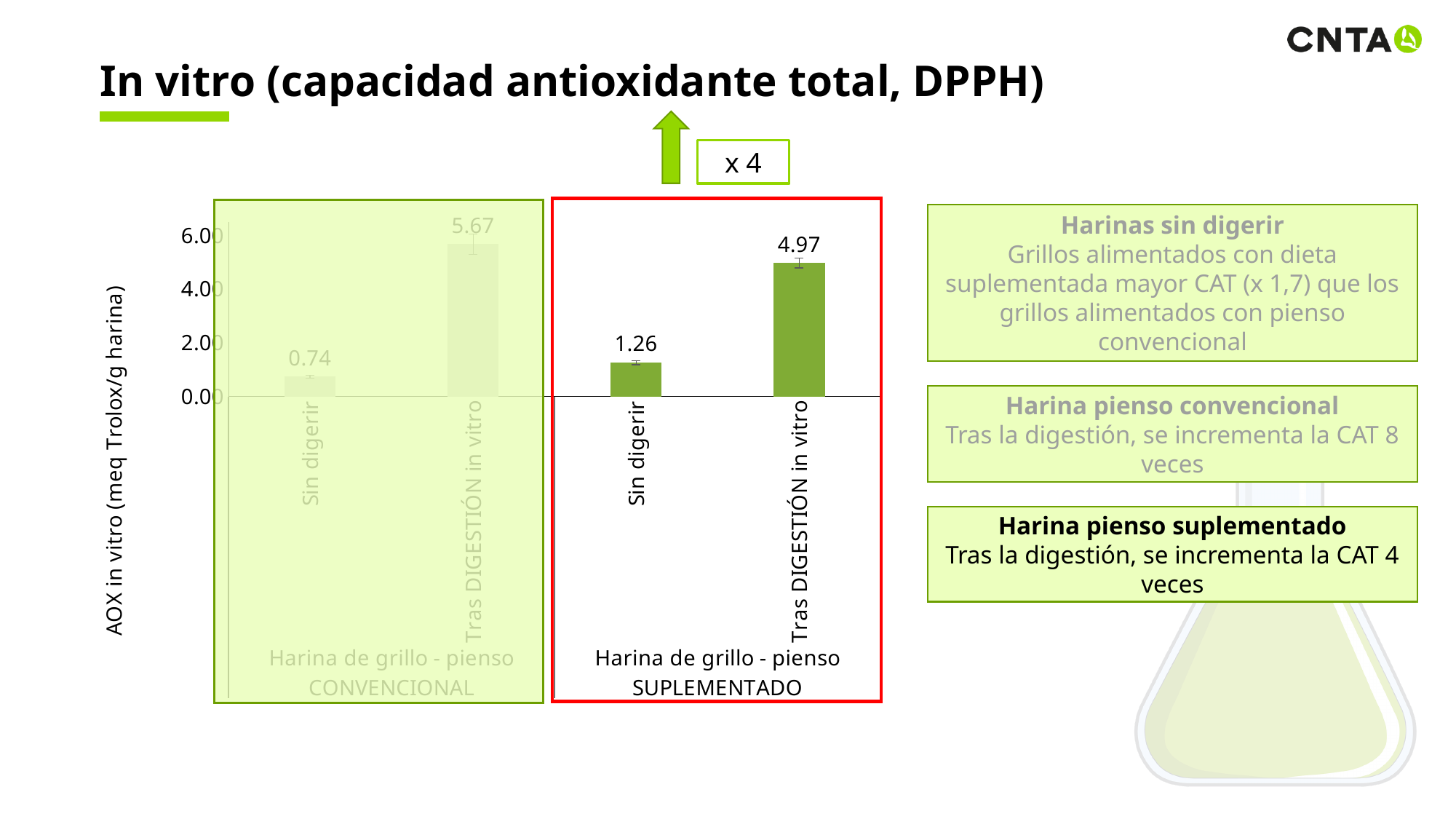
What is the value for 'Tras DIGESTIÓN in vitro' in the 'Harina de grillo - pienso SUPLEMENTADO' group? 4.97 Which bar has the lowest value in the chart? Sin digerir (CONVENCIONAL) Is the 'Tras DIGESTIÓN in vitro' value for SUPLEMENTADO greater or less than 4.00? greater How many bars are plotted in the chart? 4 What is the difference between the 'Tras DIGESTIÓN in vitro' values of the CONVENCIONAL and SUPLEMENTADO groups? 0.70 What is the label of the vertical axis of the chart? AOX in vitro (meq Trolox/g harina) What is the value for 'Sin digerir' in the 'Harina de grillo - pienso SUPLEMENTADO' group? 1.26 Which bar has the highest value in the chart? Tras DIGESTIÓN in vitro (CONVENCIONAL) Which is larger: the 'Sin digerir' value for CONVENCIONAL or for SUPLEMENTADO? SUPLEMENTADO What is the value for 'Tras DIGESTIÓN in vitro' in the 'Harina de grillo - pienso CONVENCIONAL' group? 5.67 What is the value for 'Sin digerir' in the 'Harina de grillo - pienso CONVENCIONAL' group? 0.74 What is the difference between the 'Tras DIGESTIÓN in vitro' and 'Sin digerir' values in the SUPLEMENTADO group? 3.71